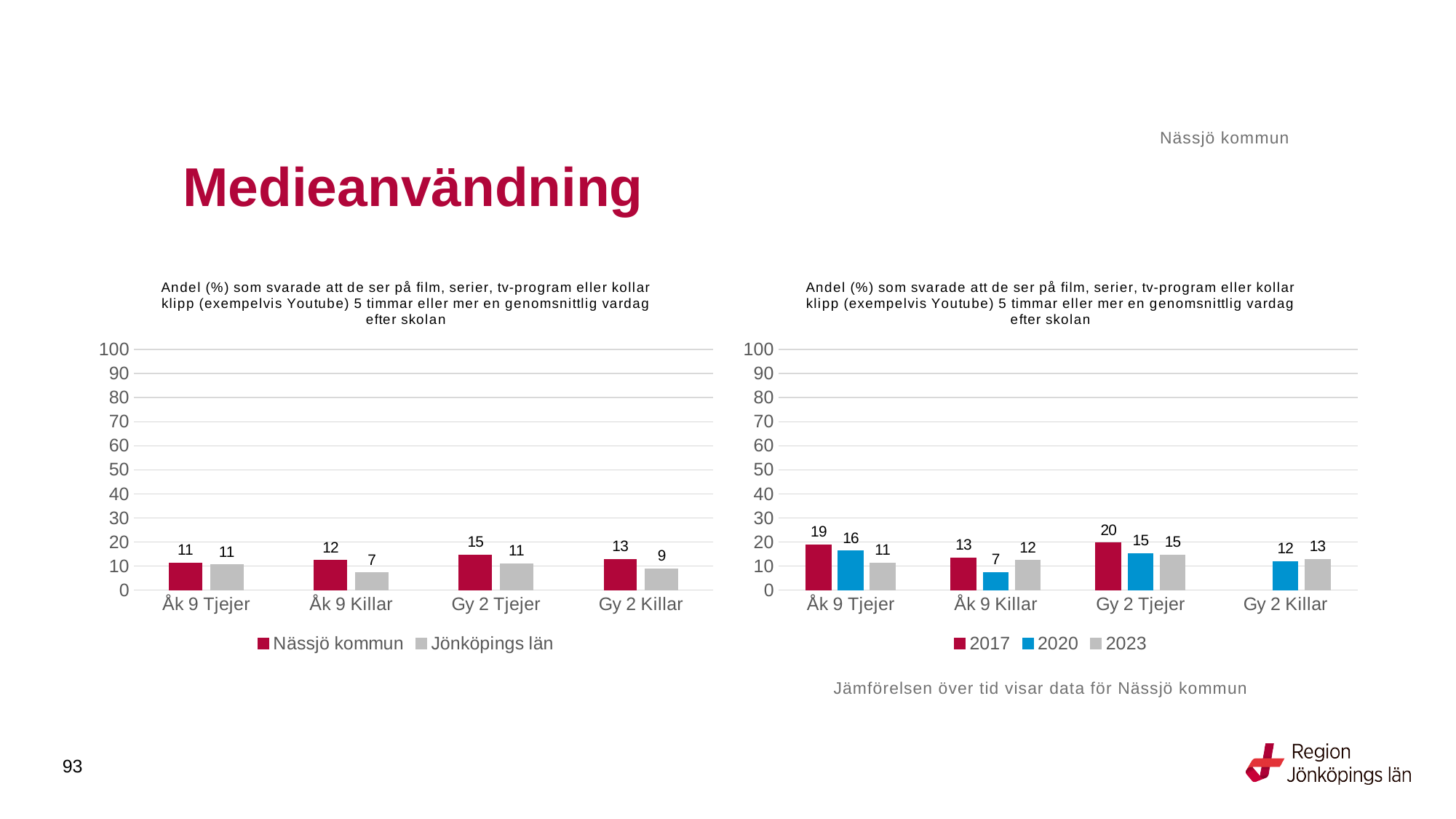
In the right chart, which category has the highest value for 2017? Gy 2 Tjejer In the right chart, what is the value for 2017 for Åk 9 Tjejer? 19 In the left chart, what is the value for Jönköpings län for Åk 9 Killar? 7 In the left chart, which category has the lowest value for Jönköpings län? Åk 9 Killar In the right chart, what is the difference between the 2017 and 2023 values for Åk 9 Tjejer? 8 What type of chart is shown on the right side of the slide? Bar chart In the left chart, how many series does the legend list? 2 In the left chart, what is the difference between Nässjö kommun and Jönköpings län for Gy 2 Killar? 4 In the right chart, what is the value for 2020 for Gy 2 Killar? 12 In the left chart, what is the value for Nässjö kommun for Gy 2 Tjejer? 15 In the left chart, which category has the highest value for Nässjö kommun? Gy 2 Tjejer In the right chart, which is larger for Åk 9 Killar: the 2020 value or the 2023 value? 2023